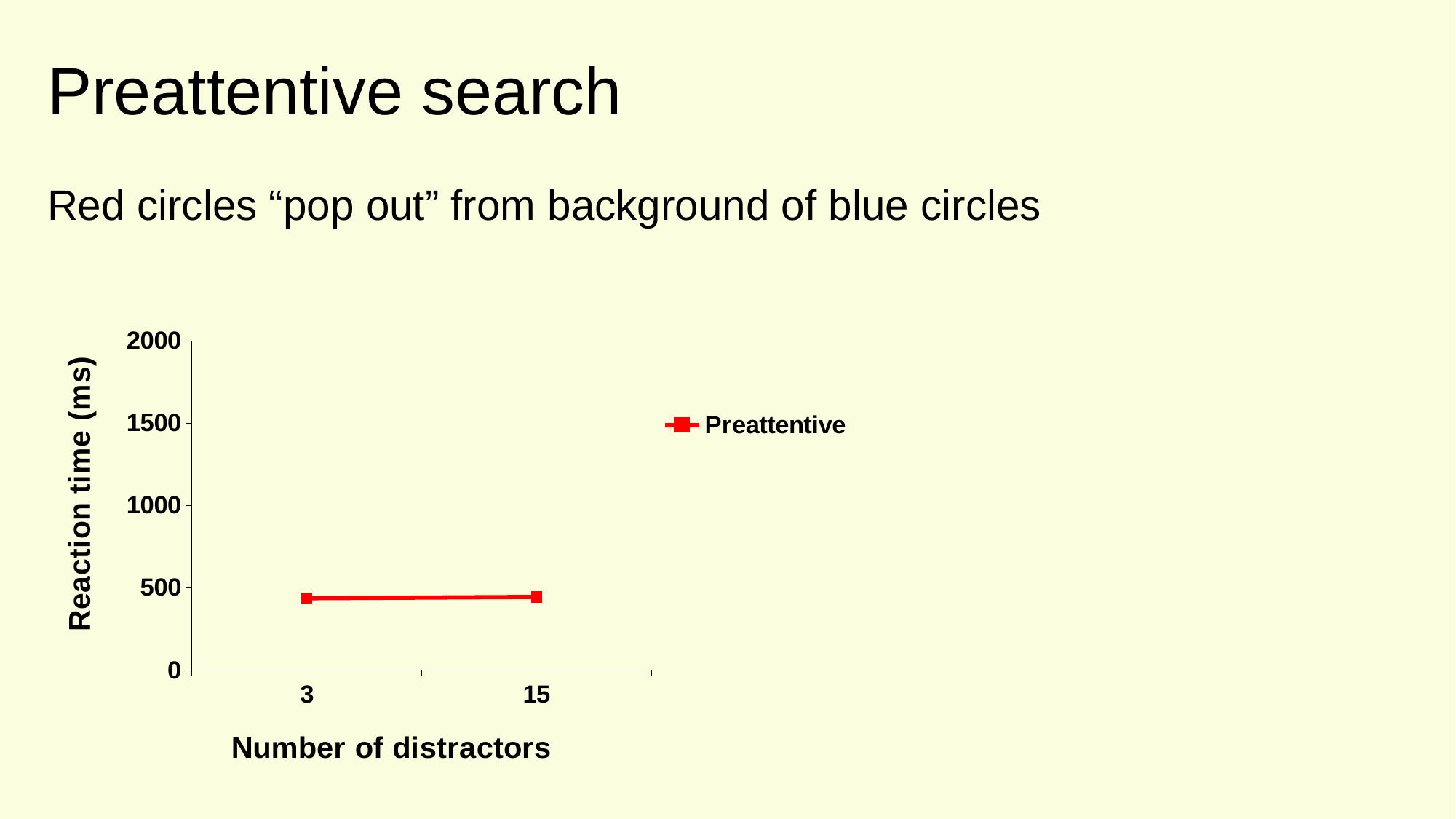
Does the Preattentive line rise steeply, fall steeply, or stay roughly flat from 3 to 15 distractors? stay roughly flat What is the name of the series shown in the chart's legend? Preattentive Is the reaction time for 3 distractors greater or less than 500? less What kind of chart is shown on the slide? line chart What is the label of the x axis of the chart? Number of distractors What are the two values of Number of distractors shown on the x axis? 3 and 15 Is the reaction time for 15 distractors greater or less than 1000? less How many series does the chart's legend list? 1 Is the reaction time for 15 distractors greater or less than 500? less How many data points are plotted on the Preattentive line? 2 What is the maximum value shown on the y axis of the chart? 2000